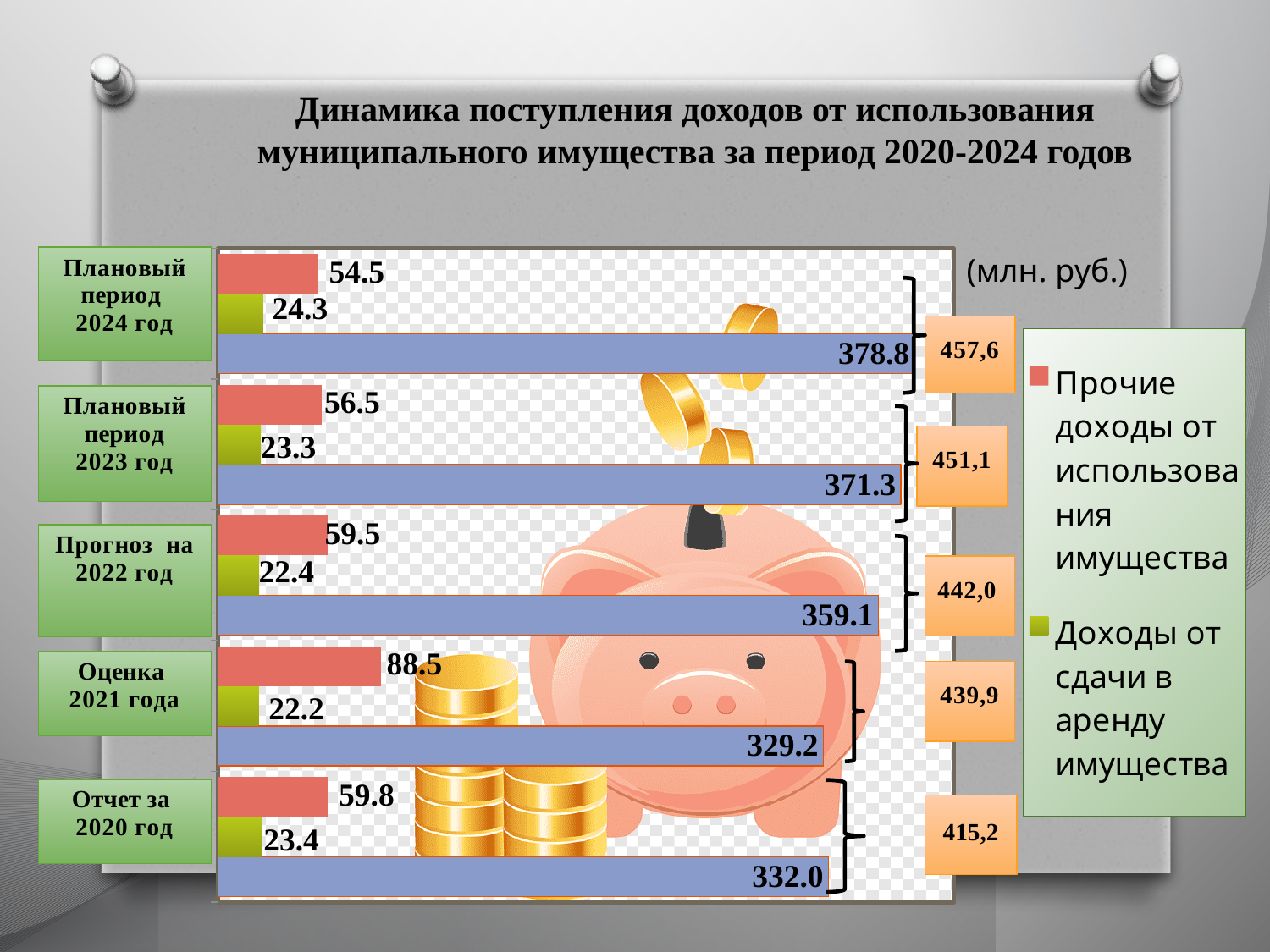
What unit of measurement is indicated on the chart? млн. руб. What is the difference between the red series values for Оценка 2021 года and Прогноз на 2022 год? 29.0 What is the value of the blue bar for Отчет за 2020 год? 332.0 What total is shown in the orange box for Плановый период 2024 год? 457,6 How many categories (periods) are shown in the chart? 5 What is the value of the red series (Прочие доходы от использования имущества) for Плановый период 2024 год? 54.5 What kind of chart is shown on the slide? Bar chart What is the value of the green series (Доходы от сдачи в аренду имущества) for Оценка 2021 года? 22.2 Which category has the lowest value for the green series (Доходы от сдачи в аренду имущества)? Оценка 2021 года How many series does the legend list? 2 Which is larger: the blue bar for Плановый период 2023 год or the blue bar for Прогноз на 2022 год? Плановый период 2023 год Which category has the highest value for the red series (Прочие доходы от использования имущества)? Оценка 2021 года